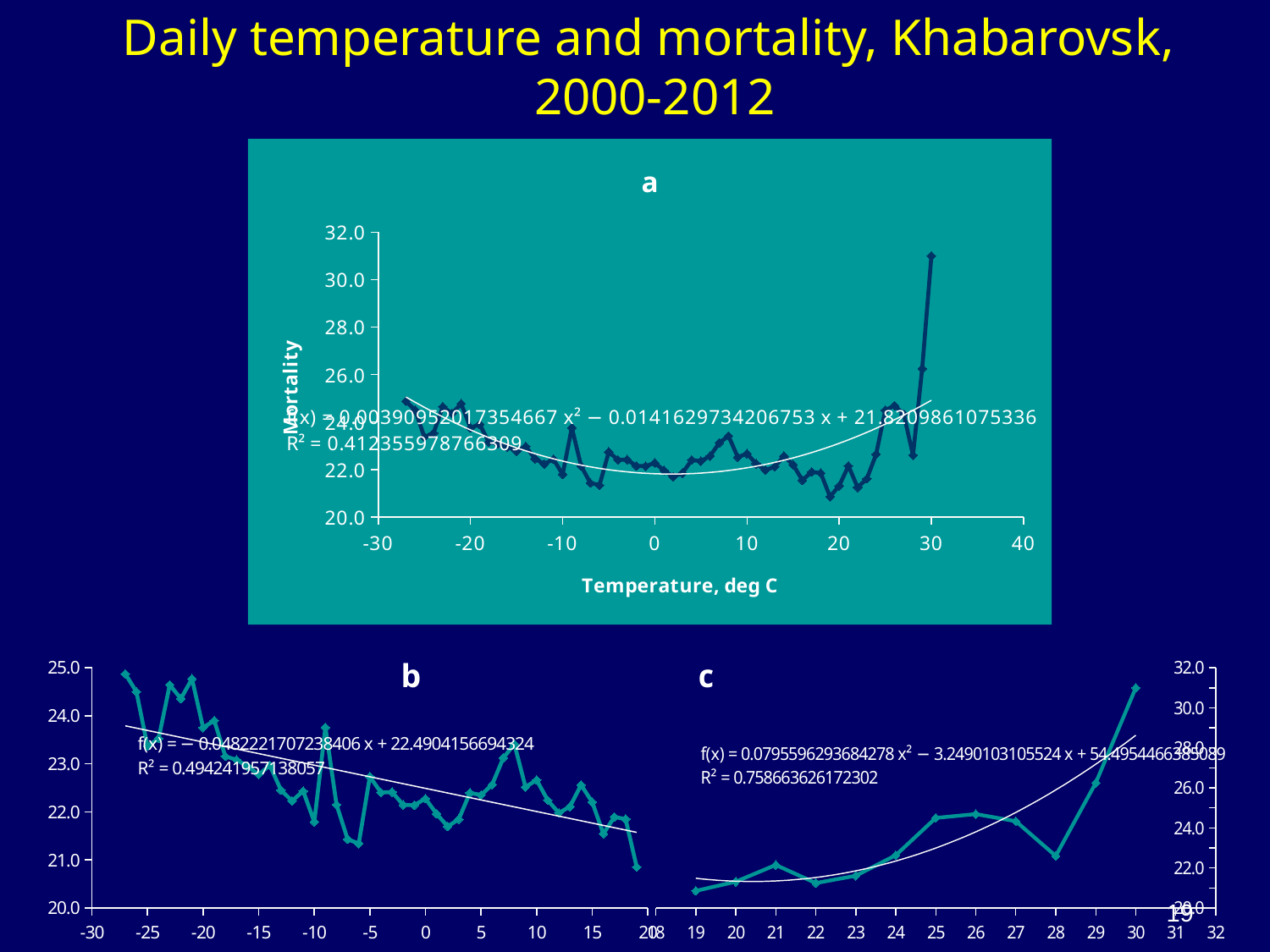
In chart a, what is the R² value printed for the fitted curve? 0.412355978766309 In chart c, what is the R² value printed for the fitted curve? 0.758663626172302 In chart a, what is the x-axis title? Temperature, deg C In chart b, is the value at -6 greater or less than 22.0? less In chart c, how many data points are plotted? 12 In chart b, what is the R² value printed for the trend line? 0.494241957138057 What kind of chart is chart a? line chart In chart a, which has the higher mortality: the point at 30 deg C or the point at 0 deg C? 30 deg C In chart a, at which temperature is mortality highest? 30 In chart b, do the values generally rise or fall as temperature increases along the x axis? fall In chart c, which has the higher value: the point at 25 or the point at 28? 25 In chart a, is the mortality value at 30 deg C greater or less than 30.0? greater